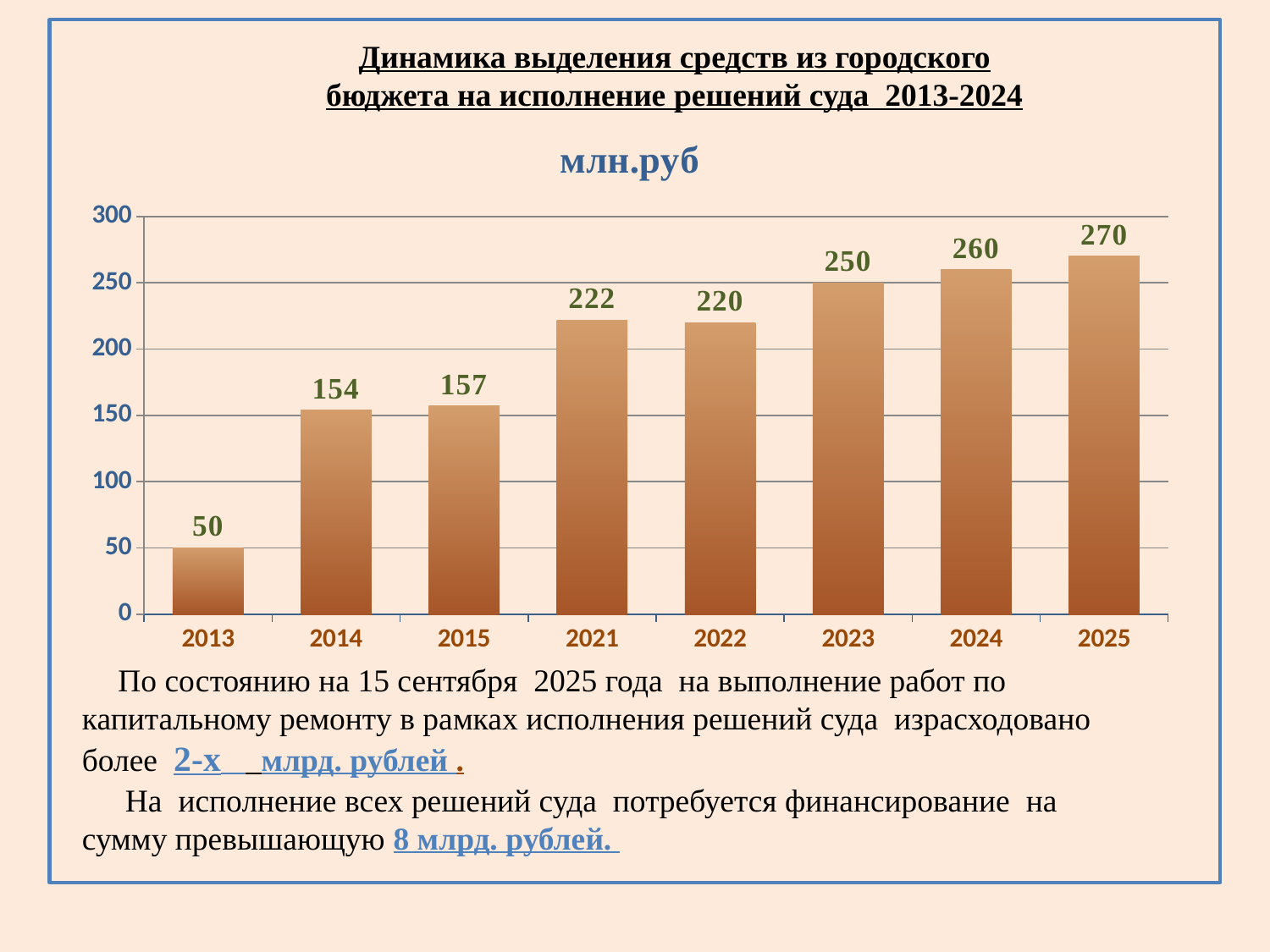
Which year has the lowest value? 2013 What is the difference between the values for 2015 and 2014? 3 What unit is shown in the chart title? млн.руб Which is larger, the value for 2021 or the value for 2022? 2021 What is the value for 2024? 260 What is the value for 2013? 50 How many years are shown on the x axis? 8 What is the value for 2021? 222 What is the difference between the values for 2025 and 2013? 220 Which year has the highest value? 2025 What kind of chart is shown on the slide? bar chart Is the value for 2023 greater or less than 200? greater